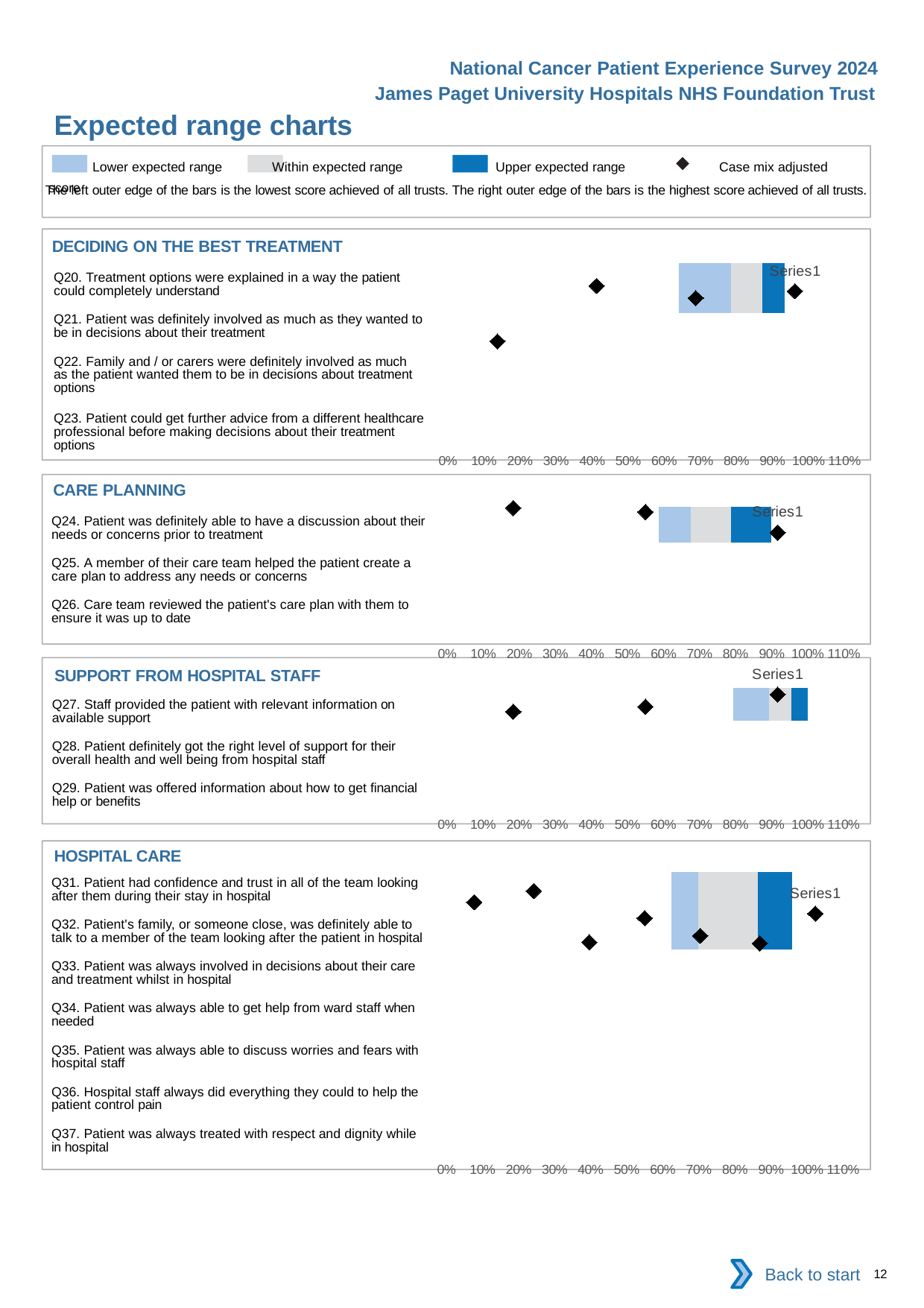
What is the lowest tick label shown on the x axis of the 'Care planning' chart? 0% How many diamond markers are plotted in the 'Care planning' chart? 3 How many questions are listed in the 'Support from hospital staff' chart? 3 How many questions are listed in the 'Hospital care' chart? 7 What is the first question listed in the 'Support from hospital staff' chart? Q27. Staff provided the patient with relevant information on available support How many entries does the legend at the top of the slide list? 4 Which legend entry is shown in dark blue? Upper expected range What kind of chart is used in the 'Deciding on the best treatment' section? bar chart What is the highest tick label shown on the x axis of the 'Hospital care' chart? 110%